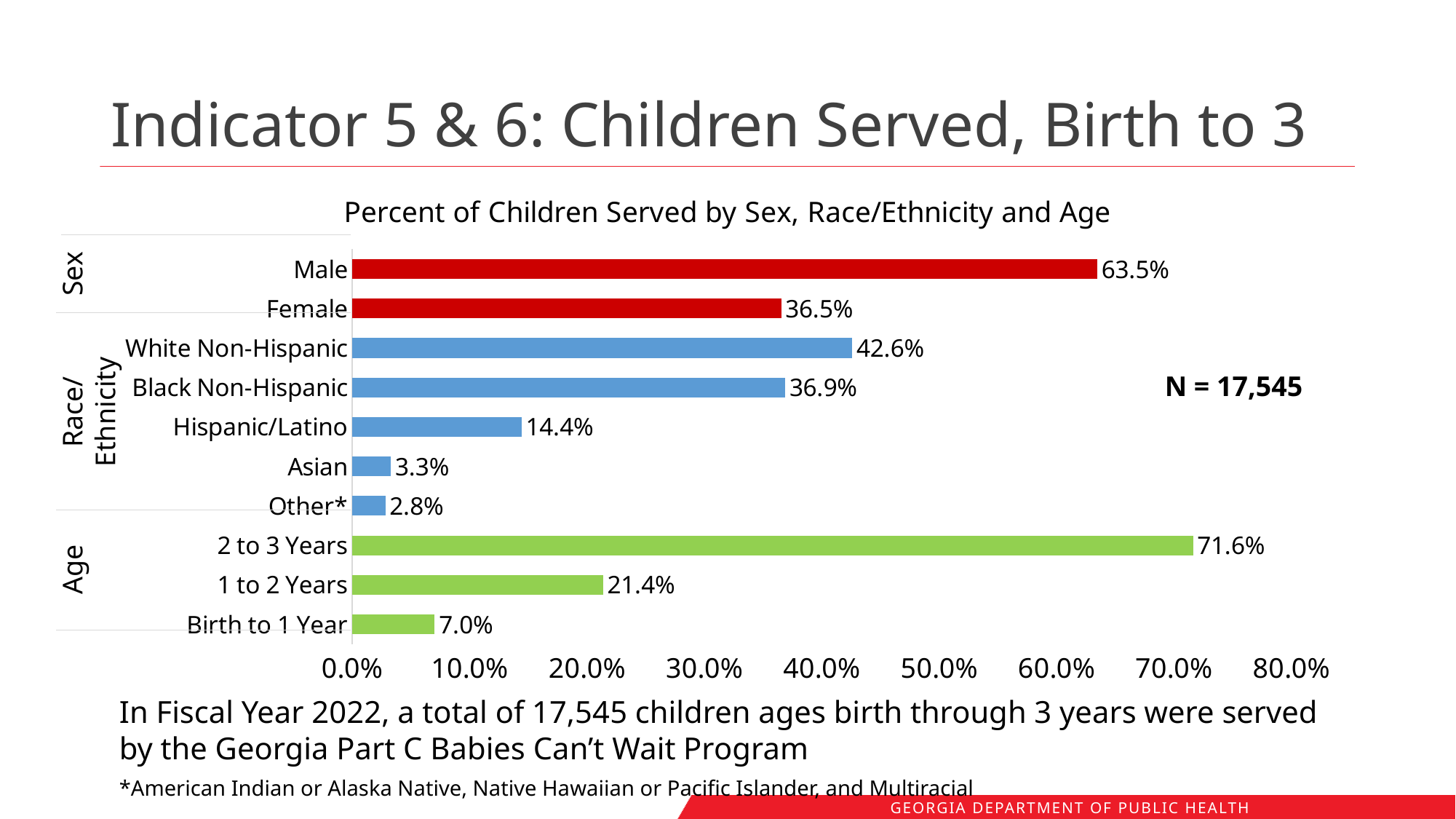
How many categories are plotted on the chart? 10 Is the value for 1 to 2 Years greater or less than 20.0%? greater What is the difference between the Male and Female percentages? 27.0% Which category has the highest value on the chart? 2 to 3 Years What percent of children served were Male? 63.5% What percent of children served were Hispanic/Latino? 14.4% Which race/ethnicity category has the lowest value? Other* What colour are the bars for the Age categories? green What is the title of the chart? Percent of Children Served by Sex, Race/Ethnicity and Age Which is larger, the value for White Non-Hispanic or Black Non-Hispanic? White Non-Hispanic What percent of children served were aged Birth to 1 Year? 7.0% What kind of chart is shown on the slide? bar chart